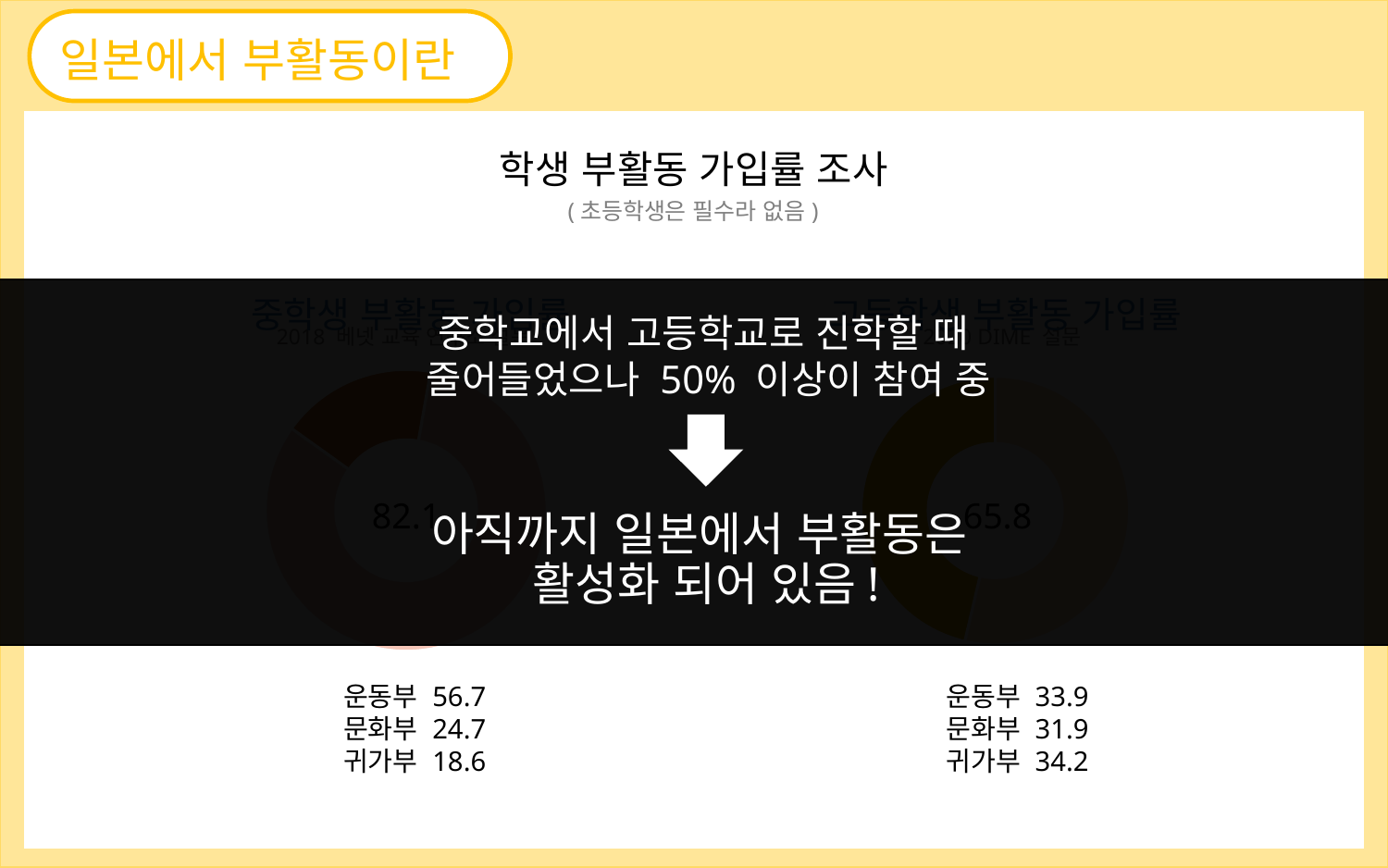
On the left chart, what is the value for 귀가부? 18.6 On the right chart, what is the value for 문화부? 31.9 What value is printed in the centre of the right chart? 65.8 Is the value for 운동부 larger on the left chart or the right chart? Left chart On the right chart, what is the value for 귀가부? 34.2 On the left chart, which category has the highest value? 운동부 What value is printed in the centre of the left chart? 82.1 On the left chart, which category has the lowest value? 귀가부 On the right chart, which category has the lowest value? 문화부 How many categories are listed for the right chart? 3 On the left chart, what is the difference between the values for 운동부 and 문화부? 32 On the left chart, what is the value for 운동부? 56.7